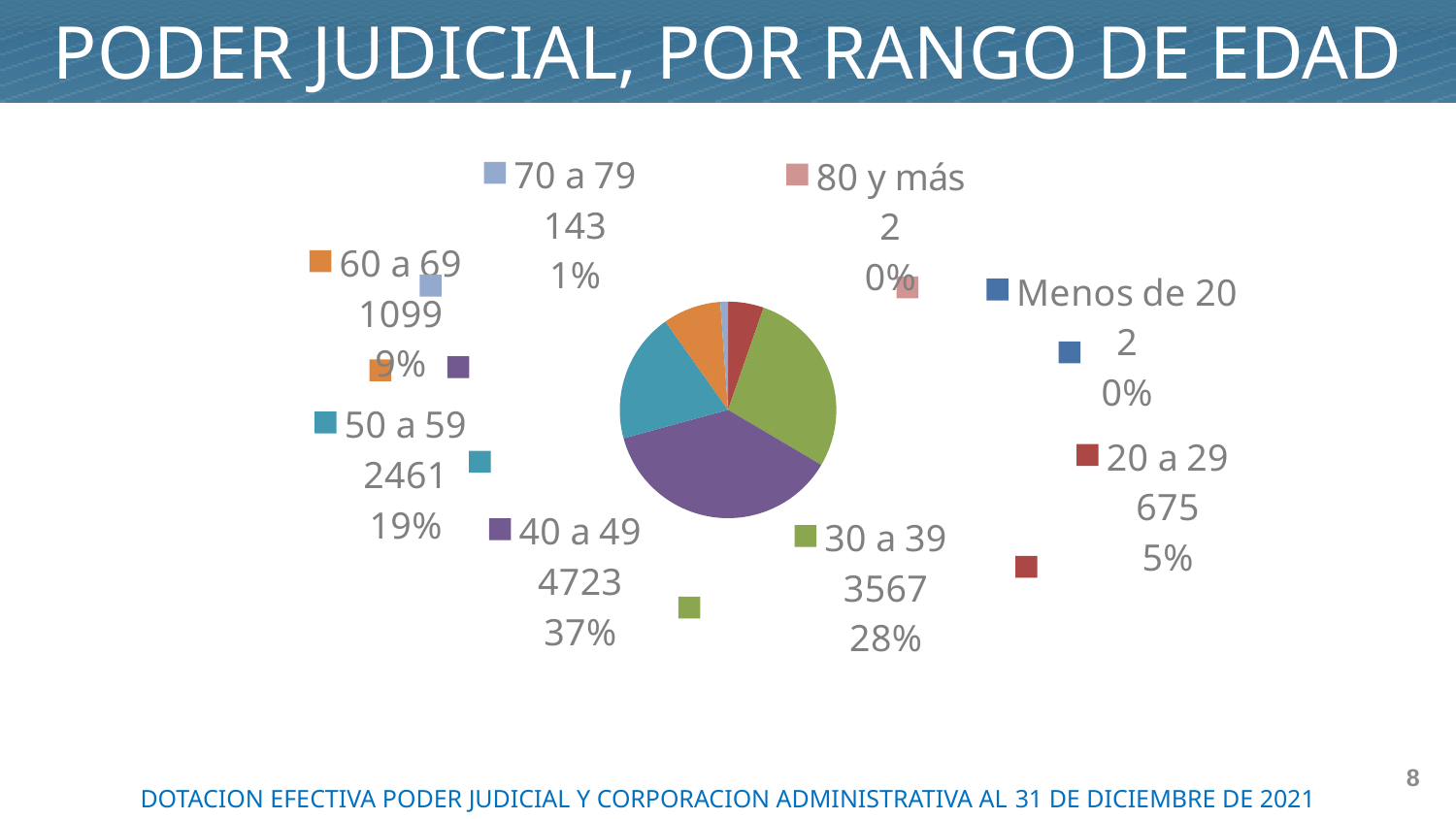
What is the value for the 70 a 79 category? 143 What is the difference between the values for 40 a 49 and 30 a 39? 1156 What percentage share does the 30 a 39 category have? 28% Which is larger, the value for 50 a 59 or the value for 60 a 69? 50 a 59 What kind of chart is shown on the slide? pie chart What percentage share does the 50 a 59 category have? 19% How many age-range categories does the pie chart show? 8 What is the value for the 40 a 49 category? 4723 What is the value for the 50 a 59 category? 2461 Which age range has the largest share of the pie? 40 a 49 What is the value for the 30 a 39 category? 3567 What is the value for the 20 a 29 category? 675